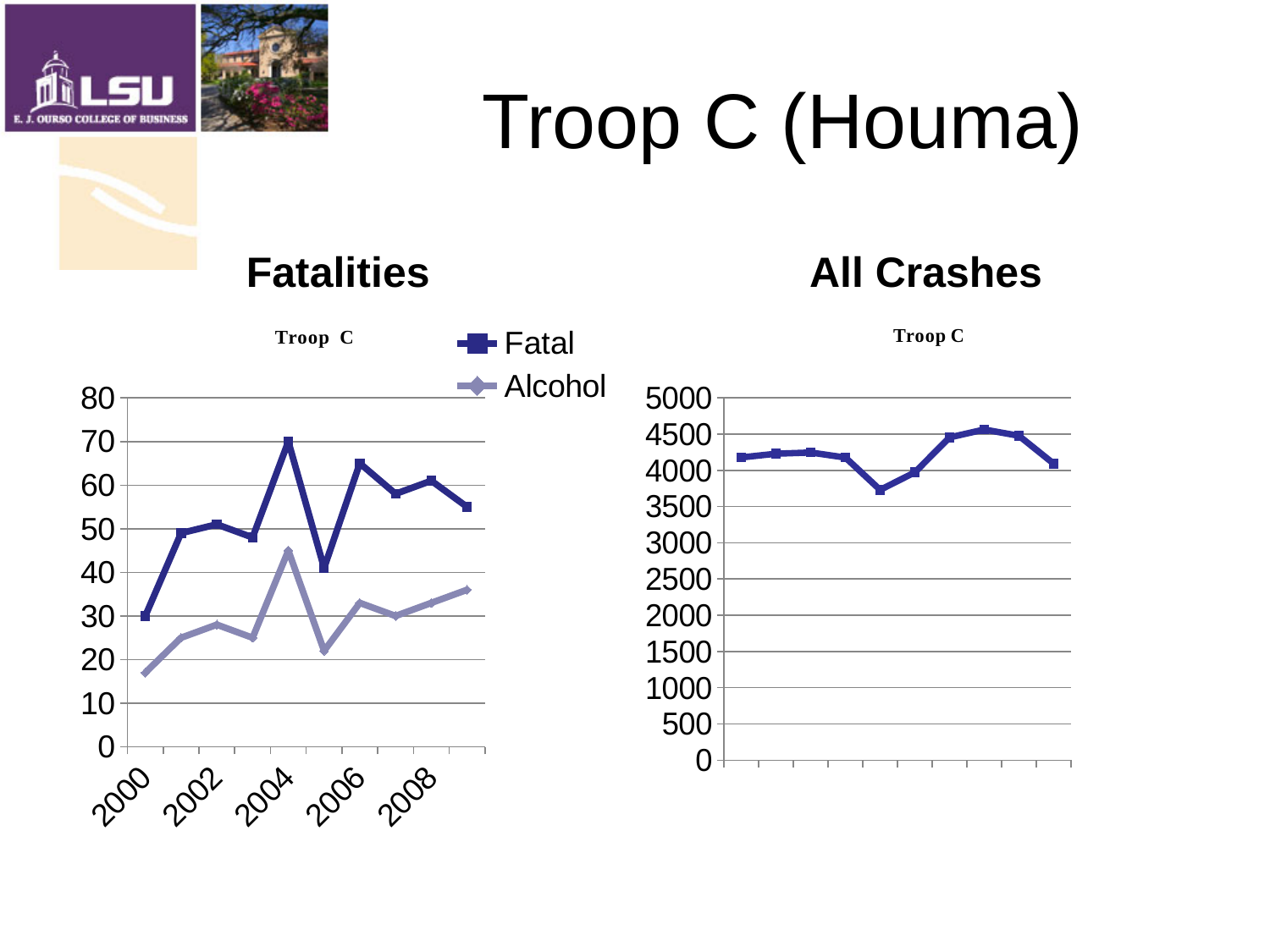
On the Fatalities chart, how many years are plotted along the x axis? 10 On the Fatalities chart, which series is larger in 2004, Fatal or Alcohol? Fatal On the All Crashes chart, what kind of chart is shown? Line chart On the Fatalities chart, what are the two series named in the legend? Fatal and Alcohol On the Fatalities chart, in which year is the Alcohol series highest? 2004 On the Fatalities chart, how many series does the legend list? 2 On the Fatalities chart, what kind of chart is shown? Line chart On the All Crashes chart, is the lowest point on the line greater or less than 4000? less On the Fatalities chart, is the Alcohol value for 2000 greater or less than 20? less On the Fatalities chart, is the Fatal value for 2004 greater or less than 60? greater On the Fatalities chart, in which year is the Fatal series highest? 2004 On the Fatalities chart, in which year is the Fatal series lowest? 2000